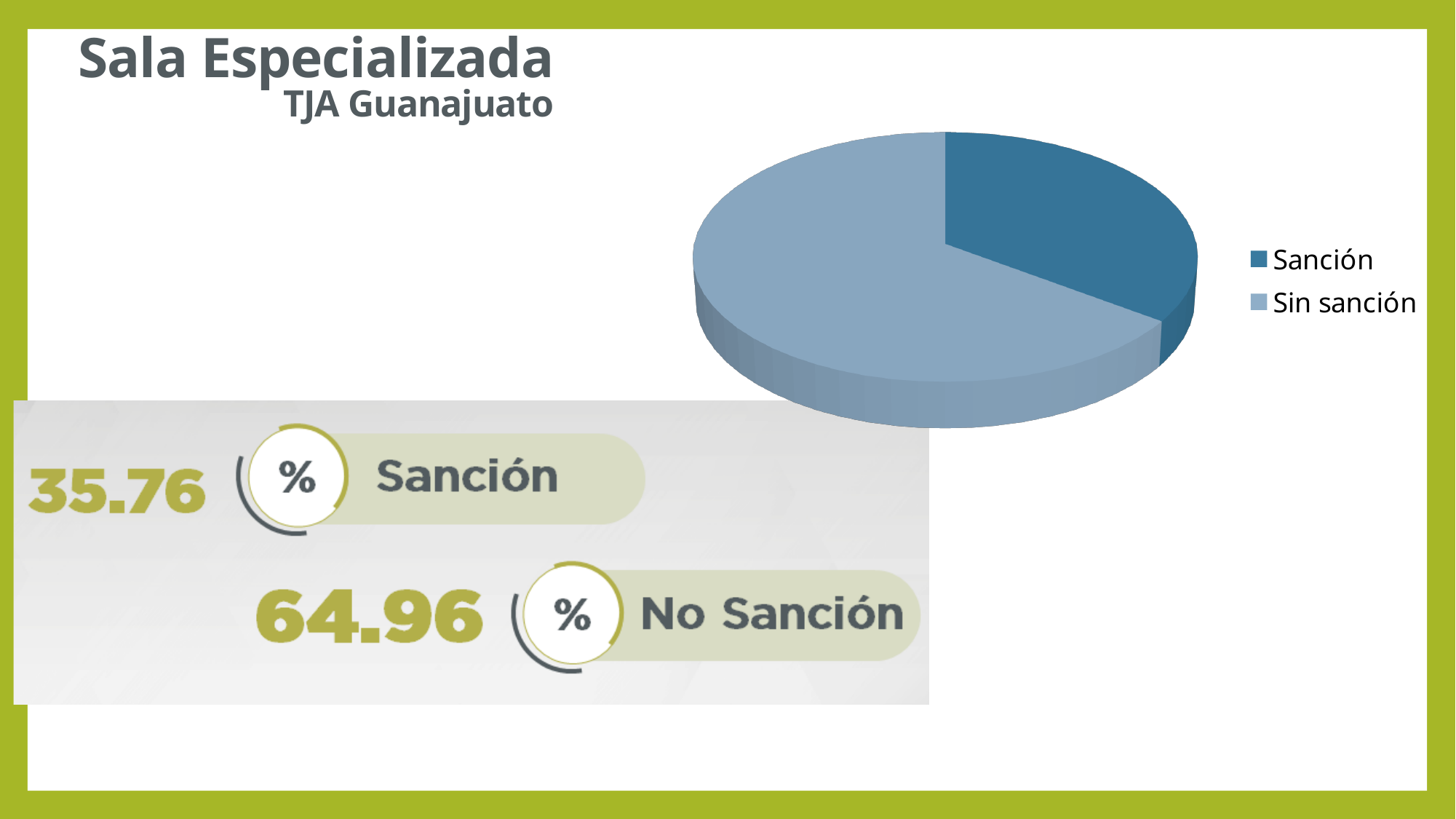
In the infographic below the pie chart, what percentage is shown for No Sanción? 64.96% Which slice of the pie chart is the largest? Sin sanción Is the Sanción slice of the pie chart more or less than half of the pie? less What kind of chart is shown on the slide? pie chart In the infographic below the pie chart, what percentage is shown for Sanción? 35.76% How many slices does the pie chart have? 2 Which slice of the pie chart is the smallest? Sanción Is the Sin sanción slice of the pie chart more or less than half of the pie? more In the pie chart, which is larger, Sanción or Sin sanción? Sin sanción What are the two legend entries of the pie chart? Sanción and Sin sanción How many entries does the pie chart's legend list? 2 Which legend entry of the pie chart is shown in the darker blue colour? Sanción